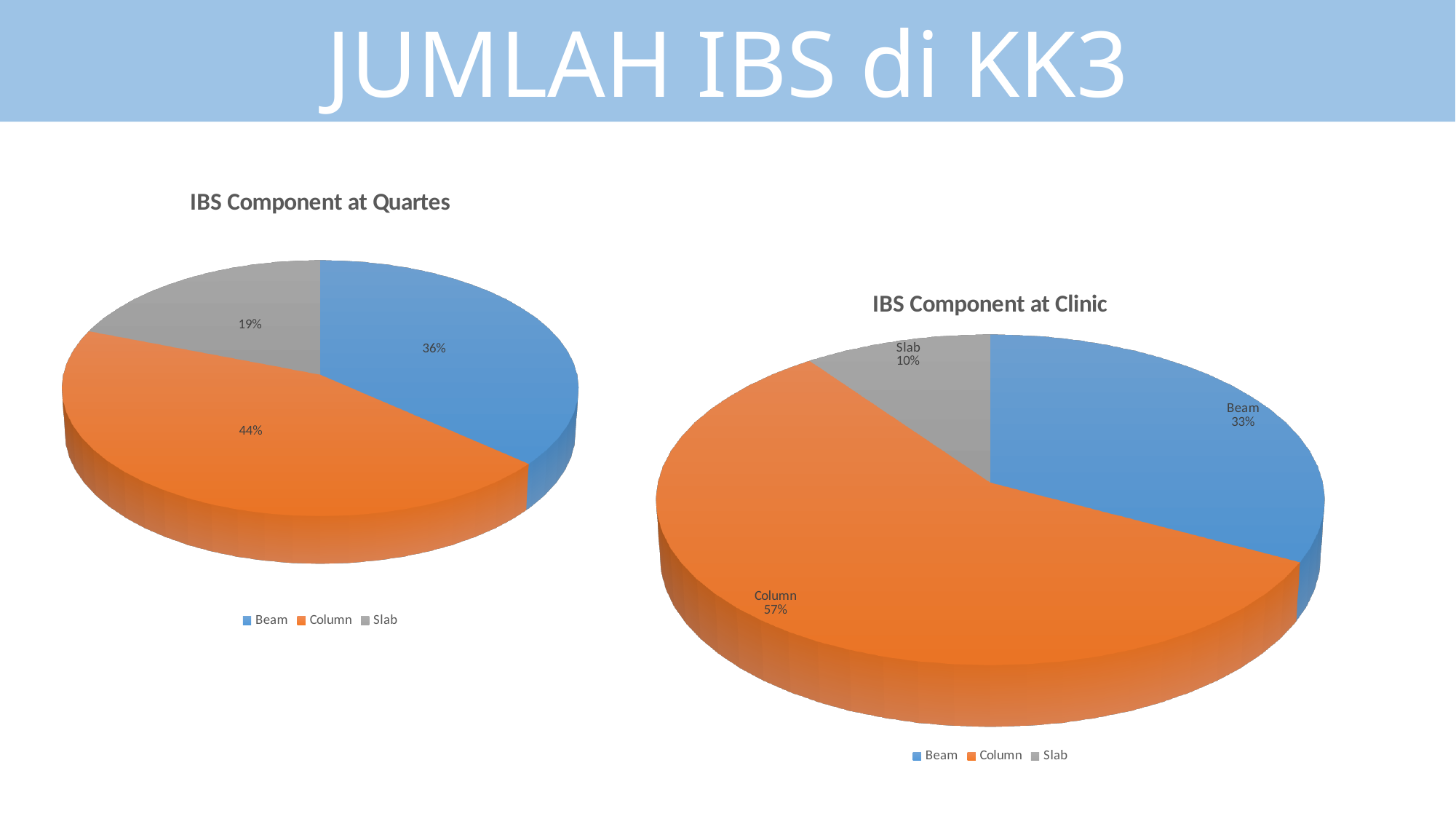
In the 'IBS Component at Clinic' chart, what percentage is shown for Column? 57% In the 'IBS Component at Quartes' chart, which is larger, Beam or Column? Column In the 'IBS Component at Quartes' chart, what percentage is shown for Column? 44% In the 'IBS Component at Clinic' chart, which component has the largest share? Column In the 'IBS Component at Quartes' chart, what percentage is shown for Beam? 36% In the 'IBS Component at Clinic' chart, what percentage is shown for Slab? 10% In the 'IBS Component at Quartes' chart, which component has the smallest share? Slab In the 'IBS Component at Quartes' chart, what percentage is shown for Slab? 19% How many slices does the 'IBS Component at Quartes' pie chart have? 3 What type of chart is 'IBS Component at Clinic'? Pie chart In the 'IBS Component at Clinic' chart, what is the difference in percentage points between Column and Beam? 24 What is the title of the chart on the right side of the slide? IBS Component at Clinic